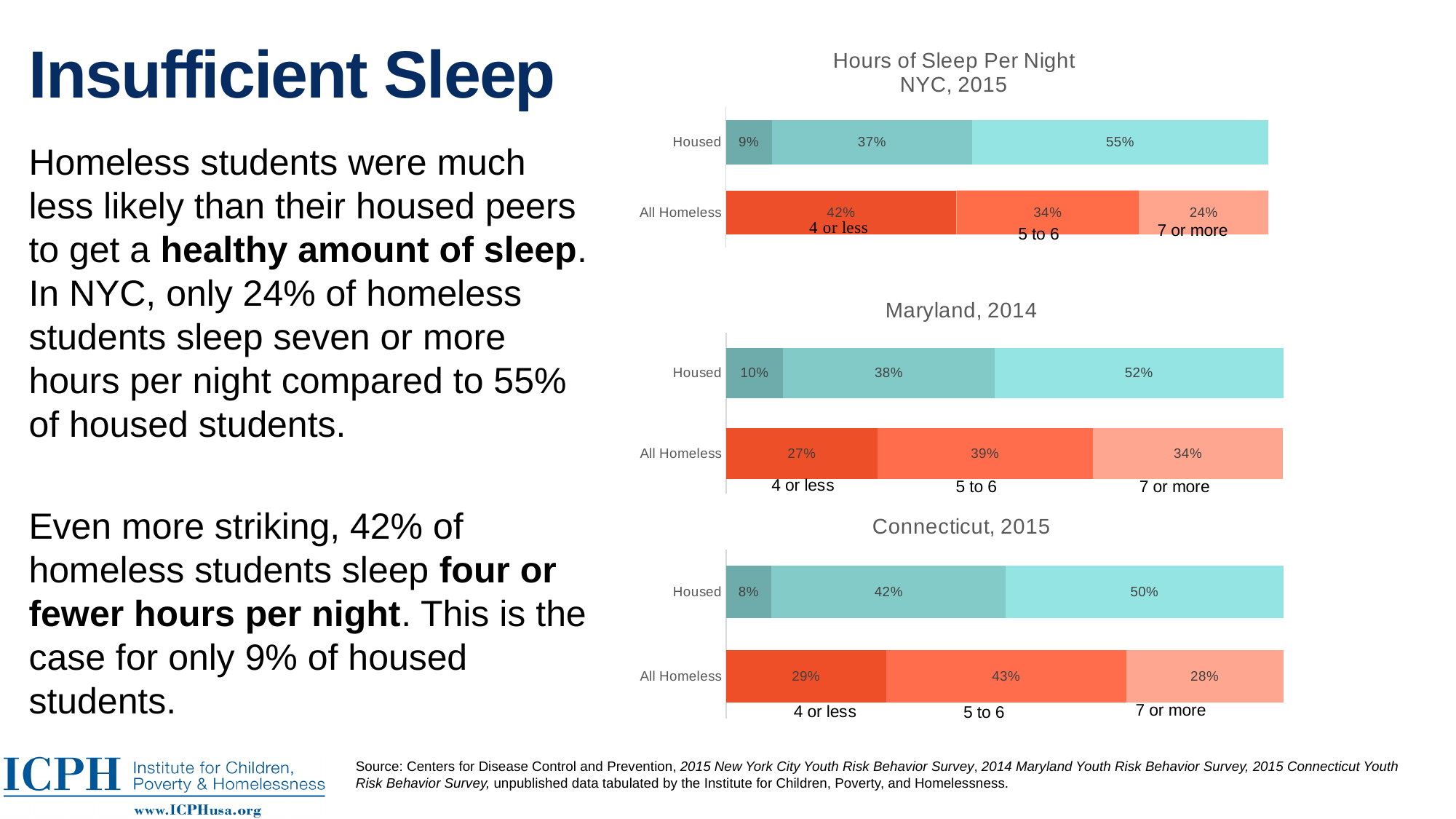
In the Maryland, 2014 chart, which segment is the largest for Housed students? 7 or more In the Connecticut, 2015 chart, what percentage of Housed students sleep 4 or less hours per night? 8% In the Connecticut, 2015 chart, which segment is the smallest for All Homeless students? 7 or more In the Maryland, 2014 chart, what percentage of All Homeless students sleep 5 to 6 hours per night? 39% In the NYC, 2015 chart, which group has the larger share sleeping 4 or less hours, Housed or All Homeless? All Homeless In the NYC, 2015 chart, what percentage of Housed students sleep 7 or more hours per night? 55% In the NYC, 2015 chart, what percentage of All Homeless students sleep 4 or less hours per night? 42% In the Maryland, 2014 chart, what is the difference between the 4 or less share for All Homeless and for Housed students? 17 percentage points How many groups (bars) are shown in the Connecticut, 2015 chart? 2 How many sleep-duration segments make up each bar in the NYC, 2015 chart? 3 What kind of chart is used for the Maryland, 2014 data? Stacked bar chart In the Connecticut, 2015 chart, what is the difference between the 7 or more share for Housed students and for All Homeless students? 22 percentage points